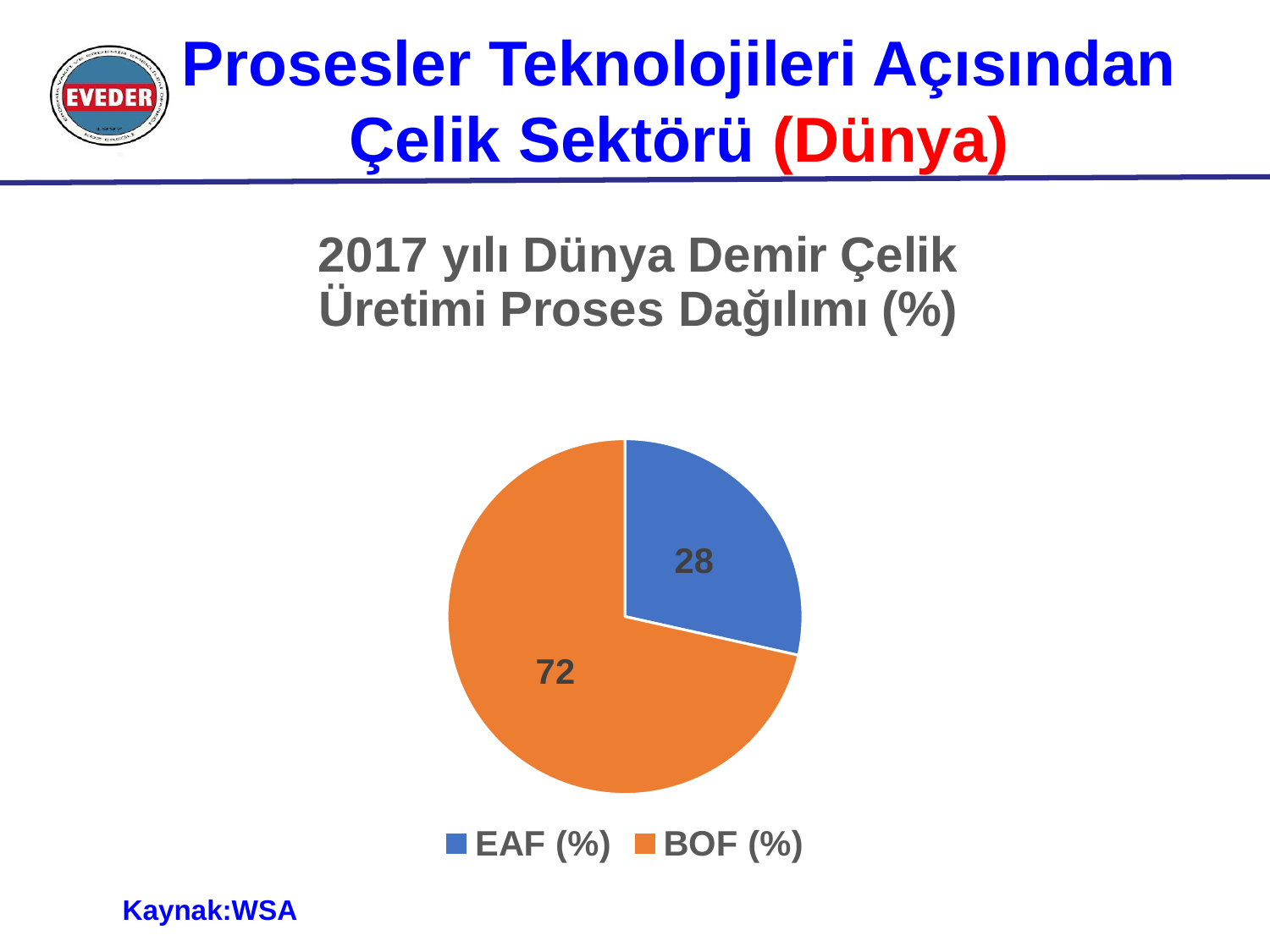
What is the total of the two slice values shown on the pie? 100 What is the difference between the BOF (%) and EAF (%) values? 44 What is the value for BOF (%)? 72 How many slices does the pie chart have? 2 Which is larger, the value for EAF (%) or the value for BOF (%)? BOF (%) Which category has the largest slice of the pie? BOF (%) How many entries does the legend list? 2 What colour is the BOF (%) slice? orange Which category has the smallest slice of the pie? EAF (%) What is the title of the chart? 2017 yılı Dünya Demir Çelik Üretimi Proses Dağılımı (%) What is the value for EAF (%)? 28 What kind of chart is shown on the slide? pie chart